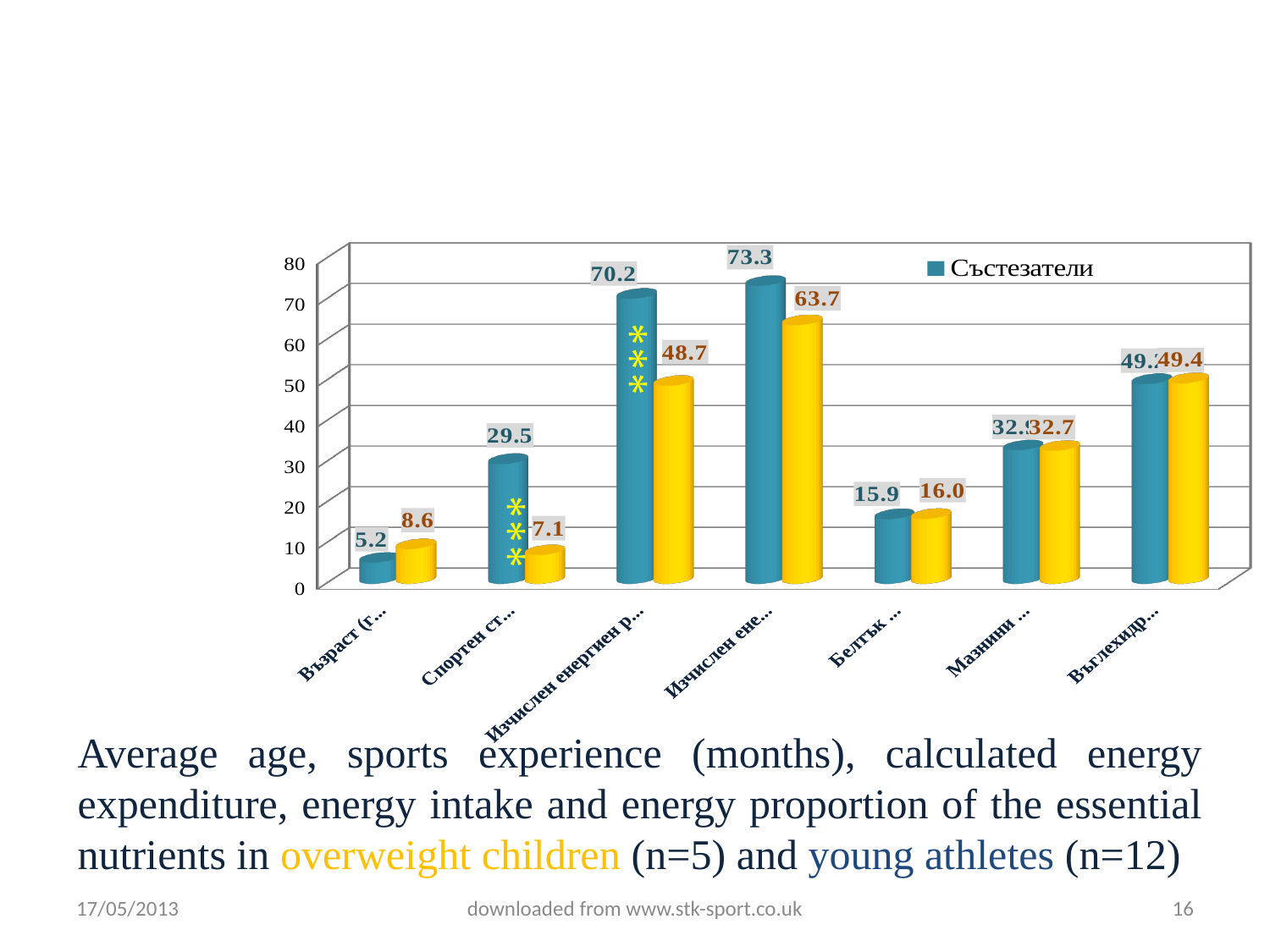
What is the value of the yellow bar for the fourth category, 'Изчислен ене...'? 63.7 What is the difference between the blue and yellow bars for the second category, 'Спортен ст...'? 22.4 What is the value of the blue bar for the second category, 'Спортен ст...'? 29.5 How many categories are shown on the x axis? 7 What is the value of the yellow bar for the first category, 'Възраст (г...'? 8.6 Which category has the highest blue bar? Изчислен ене... (the fourth category), 73.3 What is the value of the yellow bar for the second category, 'Спортен ст...'? 7.1 What is the value of the blue bar for the first category, 'Възраст (г...'? 5.2 What kind of chart is shown on the slide? Bar chart What is the value of the yellow bar for the third category, 'Изчислен енергиен р...'? 48.7 What is the difference between the blue and yellow bars for the third category, 'Изчислен енергиен р...'? 21.5 Which category has the lowest blue bar? Възраст (г... (the first category), 5.2